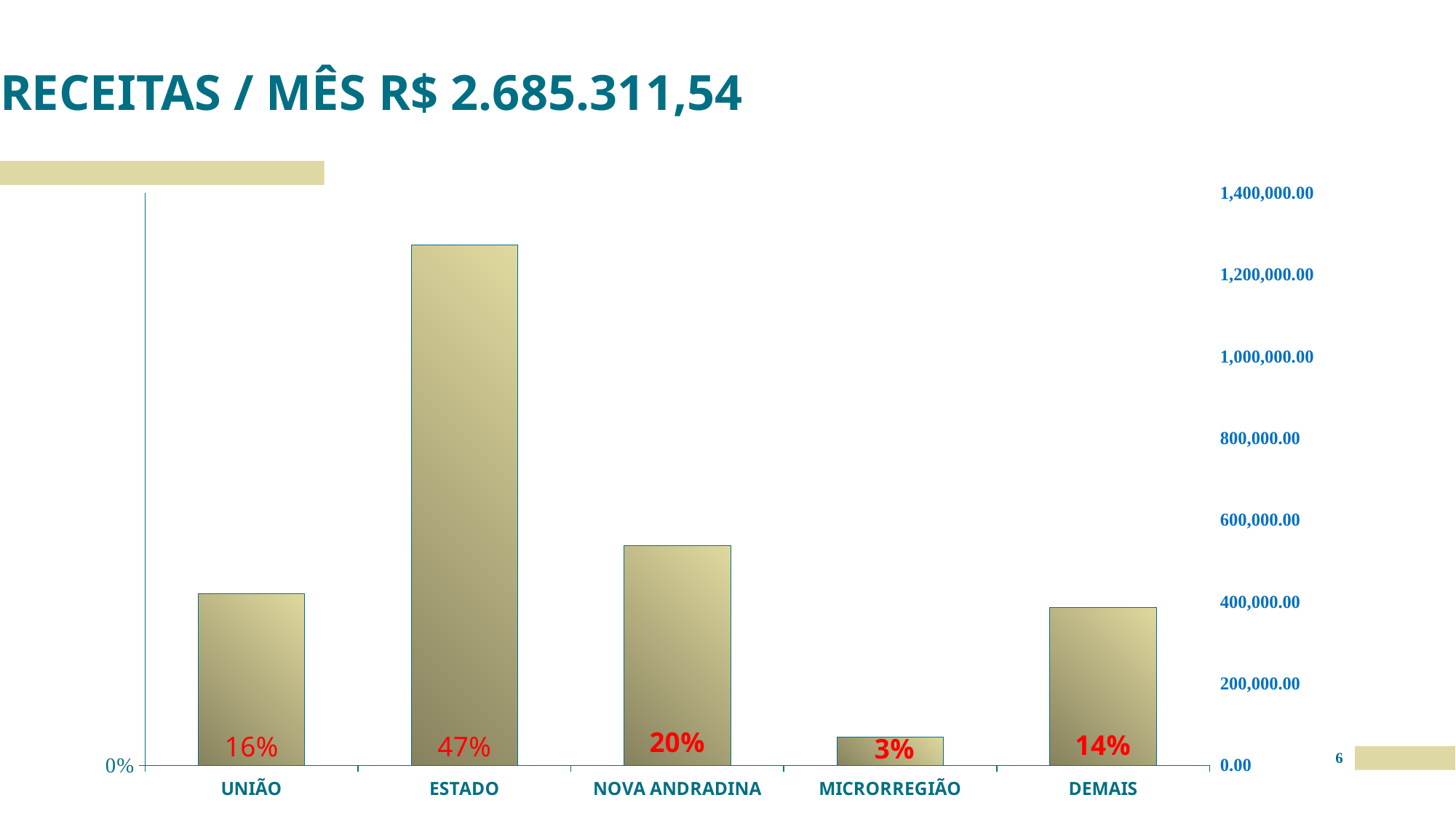
How many categories are shown on the x axis? 5 Is the value for ESTADO greater or less than 1,200,000.00? greater What percentage label is shown on the MICRORREGIÃO bar? 3% What percentage label is shown on the DEMAIS bar? 14% Which is larger, the bar for UNIÃO or the bar for DEMAIS? UNIÃO What is the title of the slide? RECEITAS / MÊS R$ 2.685.311,54 What percentage label is shown on the ESTADO bar? 47% What percentage label is shown on the NOVA ANDRADINA bar? 20% What is the difference in percentage points between the ESTADO and UNIÃO labels? 31 percentage points Which category has the highest bar? ESTADO Is the value for NOVA ANDRADINA greater or less than 600,000.00? less Which category has the lowest bar? MICRORREGIÃO